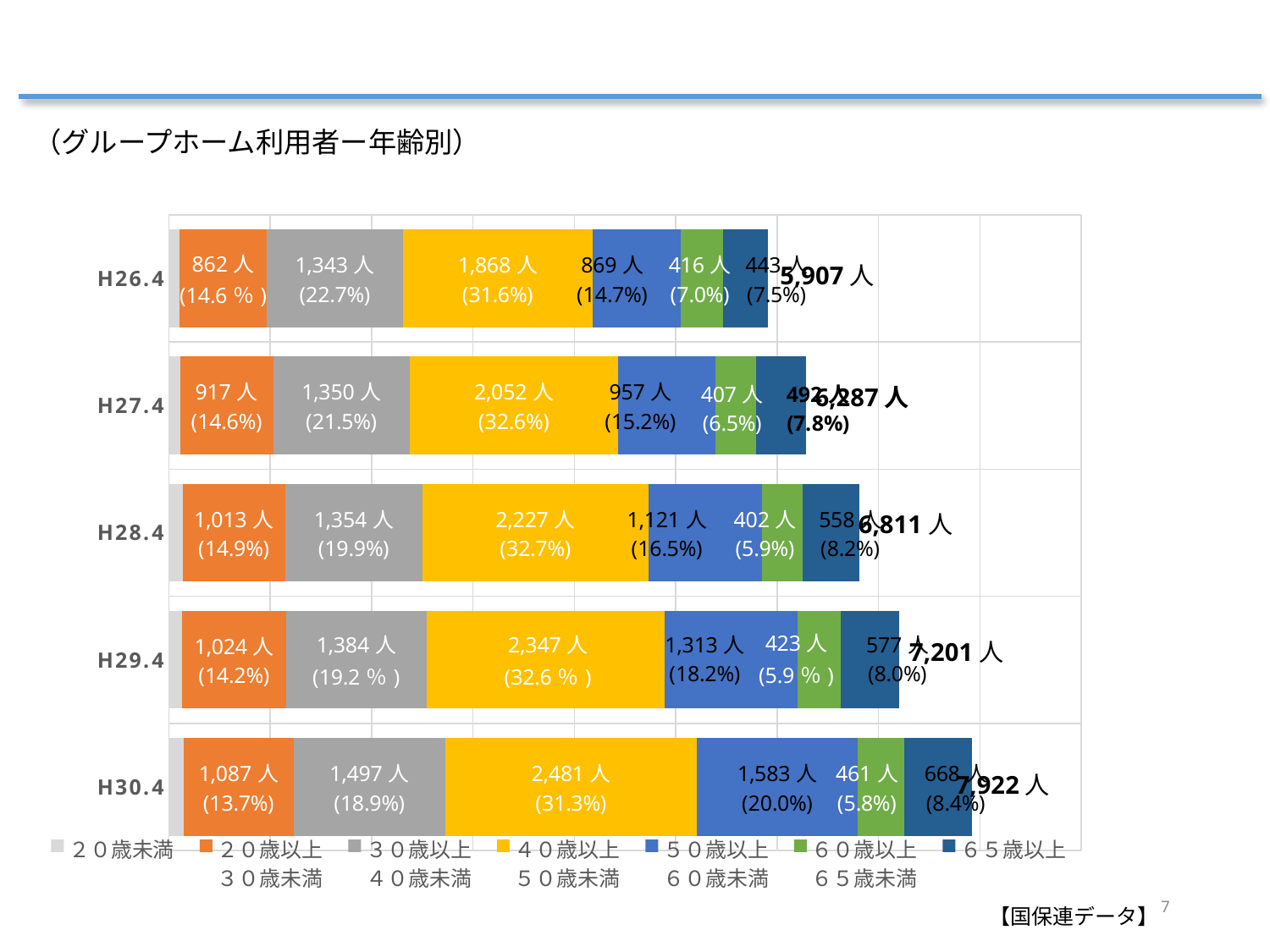
How many years (bars) are shown in the chart? 5 Which year has the lowest total number of users? H26.4 What percentage is shown for 50歳以上60歳未満 in H30.4? 20.0% Do the total numbers of users rise or fall from H26.4 to H30.4? Rise What is the value for 40歳以上50歳未満 in H30.4? 2,481人 What is the total shown for the H28.4 bar? 6,811人 Which year has the highest total number of users? H30.4 How many series does the legend list? 7 What is the difference between the total for H30.4 and the total for H26.4? 2,015人 In H29.4, which is larger: 50歳以上60歳未満 or 30歳以上40歳未満? 30歳以上40歳未満 What kind of chart is this? Stacked bar chart What is the value for 30歳以上40歳未満 in H26.4? 1,343人